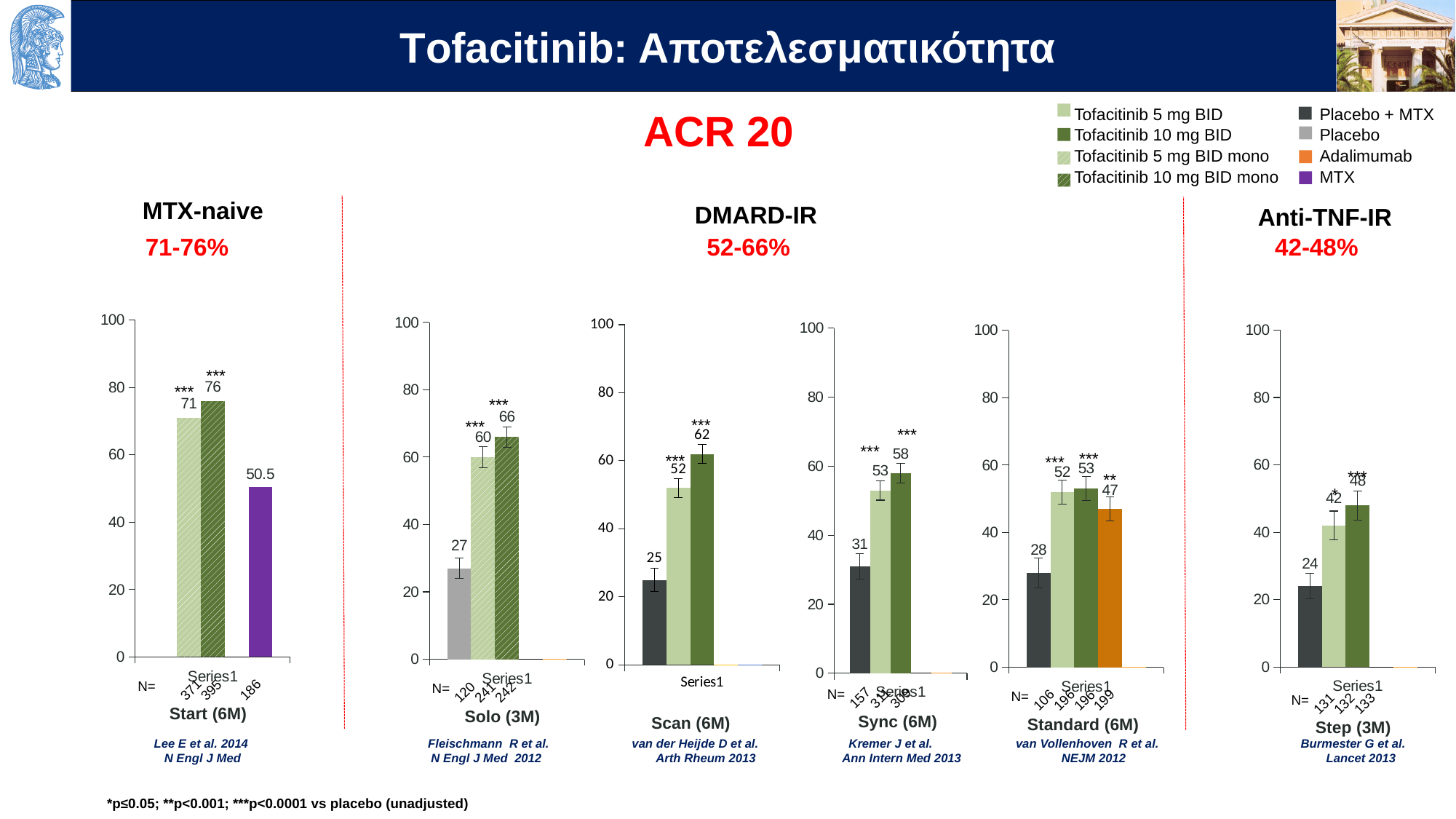
In the Step (3M) chart, what is the value for Tofacitinib 10 mg BID? 48 In the Sync (6M) chart, which bar is the lowest? Placebo + MTX In the Start (6M) chart, what is the value for Tofacitinib 10 mg BID mono? 76 How many entries does the shared legend at the top of the slide list? 8 What type of chart is the Solo (3M) chart? Bar chart In the Start (6M) chart, what is the value for the MTX bar? 50.5 In the Scan (6M) chart, which bar is the highest? Tofacitinib 10 mg BID In the Solo (3M) chart, what is the value for the Placebo bar? 27 In the Standard (6M) chart, which is larger: the Tofacitinib 5 mg BID bar or the Adalimumab bar? Tofacitinib 5 mg BID How many bars are plotted in the Standard (6M) chart? 4 In the Standard (6M) chart, what is the value for the Adalimumab bar? 47 In the Scan (6M) chart, what is the difference between the Tofacitinib 10 mg BID bar and the Placebo + MTX bar? 37